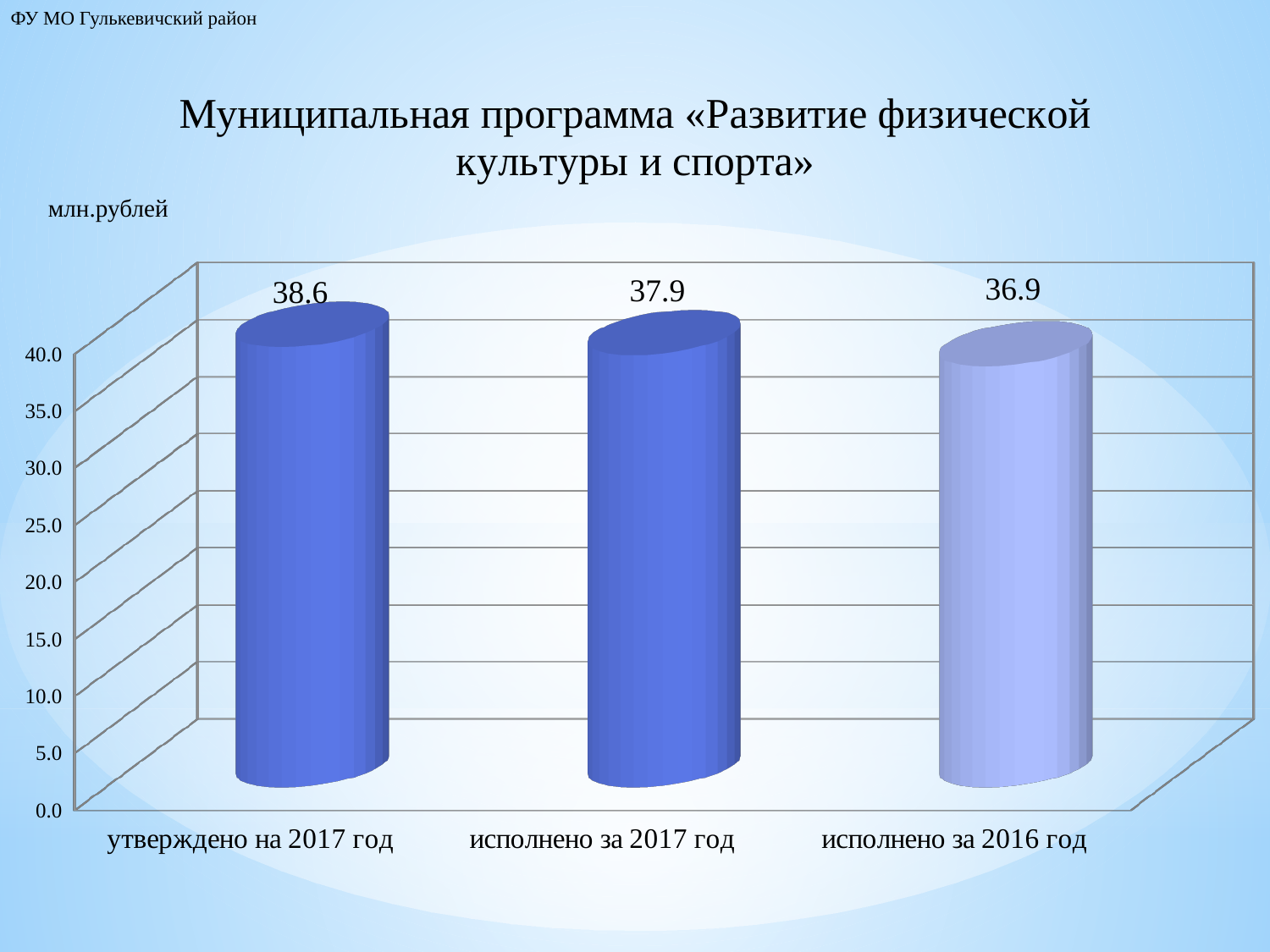
What is the difference between «утверждено на 2017 год» and «исполнено за 2017 год»? 0.7 What kind of chart is shown on the slide? bar chart What is the value for «исполнено за 2016 год»? 36.9 Which category has the highest value? утверждено на 2017 год What is the value for «исполнено за 2017 год»? 37.9 Do the values rise or fall from left to right along the x axis? fall Which is larger: «исполнено за 2017 год» or «исполнено за 2016 год»? исполнено за 2017 год Which category has the lowest value? исполнено за 2016 год How many categories are shown in the chart? 3 What is the value for «утверждено на 2017 год»? 38.6 What unit of measurement is indicated above the chart? млн.рублей What is the difference between «исполнено за 2017 год» and «исполнено за 2016 год»? 1.0